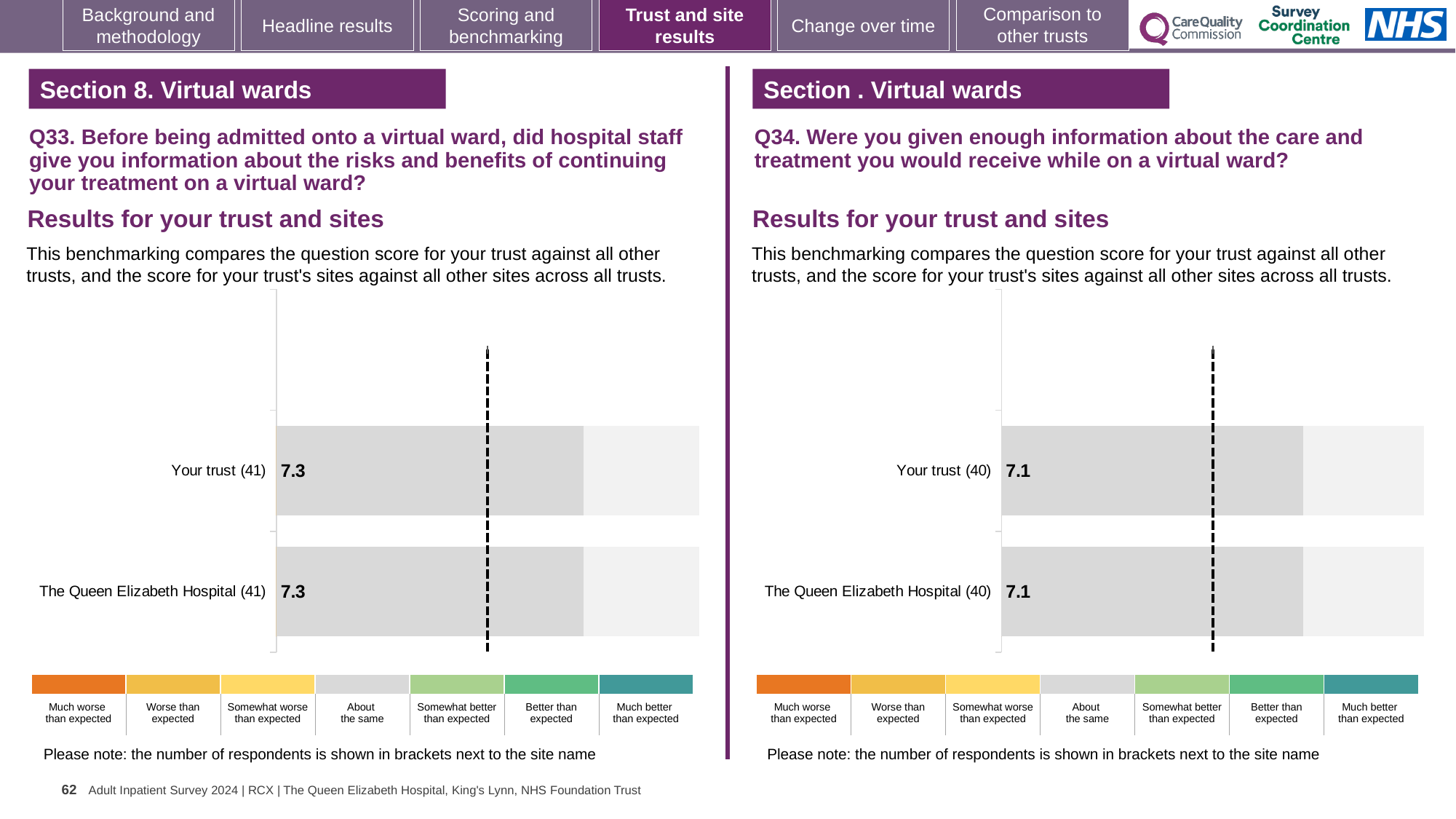
In the Q33 chart on the left, what is the score for The Queen Elizabeth Hospital? 7.3 In the Q33 chart on the left, how many respondents are shown in brackets next to Your trust? 41 In the Q34 chart on the right, what is the score for Your trust? 7.1 In the Q33 chart on the left, what is the difference between the score for Your trust and the score for The Queen Elizabeth Hospital? 0 How many bars are plotted in the Q33 chart on the left? 2 How many bars are plotted in the Q34 chart on the right? 2 What kind of chart is used for the Q33 results on the left? Bar chart Is the score for Your trust in the Q33 chart on the left larger than the score for Your trust in the Q34 chart on the right? Yes In the Q34 chart on the right, what is the difference between the score for Your trust and the score for The Queen Elizabeth Hospital? 0 In the Q34 chart on the right, what is the score for The Queen Elizabeth Hospital? 7.1 In the Q34 chart on the right, how many respondents are shown in brackets next to The Queen Elizabeth Hospital? 40 In the Q33 chart on the left, what is the score for Your trust? 7.3